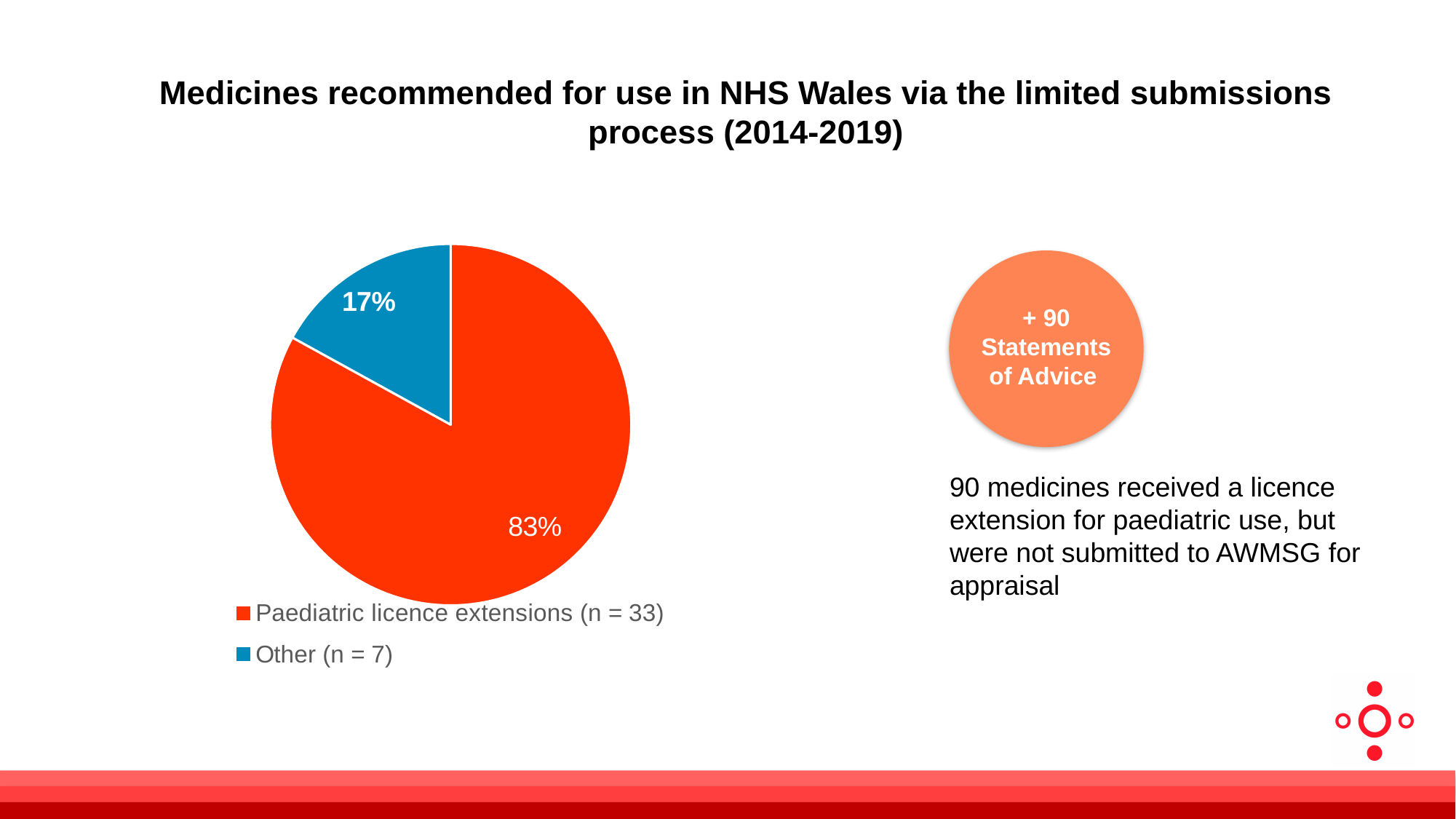
What share of the pie does 'Other (n = 7)' represent? 17% How many slices does the pie chart have? 2 Which slice is larger: 'Paediatric licence extensions' or 'Other'? Paediatric licence extensions What share of the pie does 'Paediatric licence extensions (n = 33)' represent? 83% How many medicines are in the 'Paediatric licence extensions' category according to the legend? 33 What is the difference in percentage points between the 'Paediatric licence extensions' slice and the 'Other' slice? 66 What kind of chart is shown on the slide? pie chart How many medicines are in the 'Other' category according to the legend? 7 What is the title of the slide containing the pie chart? Medicines recommended for use in NHS Wales via the limited submissions process (2014-2019) Which slice of the pie is the largest? Paediatric licence extensions (n = 33) Which slice of the pie is the smallest? Other (n = 7) What colour is the 'Other (n = 7)' slice of the pie? blue